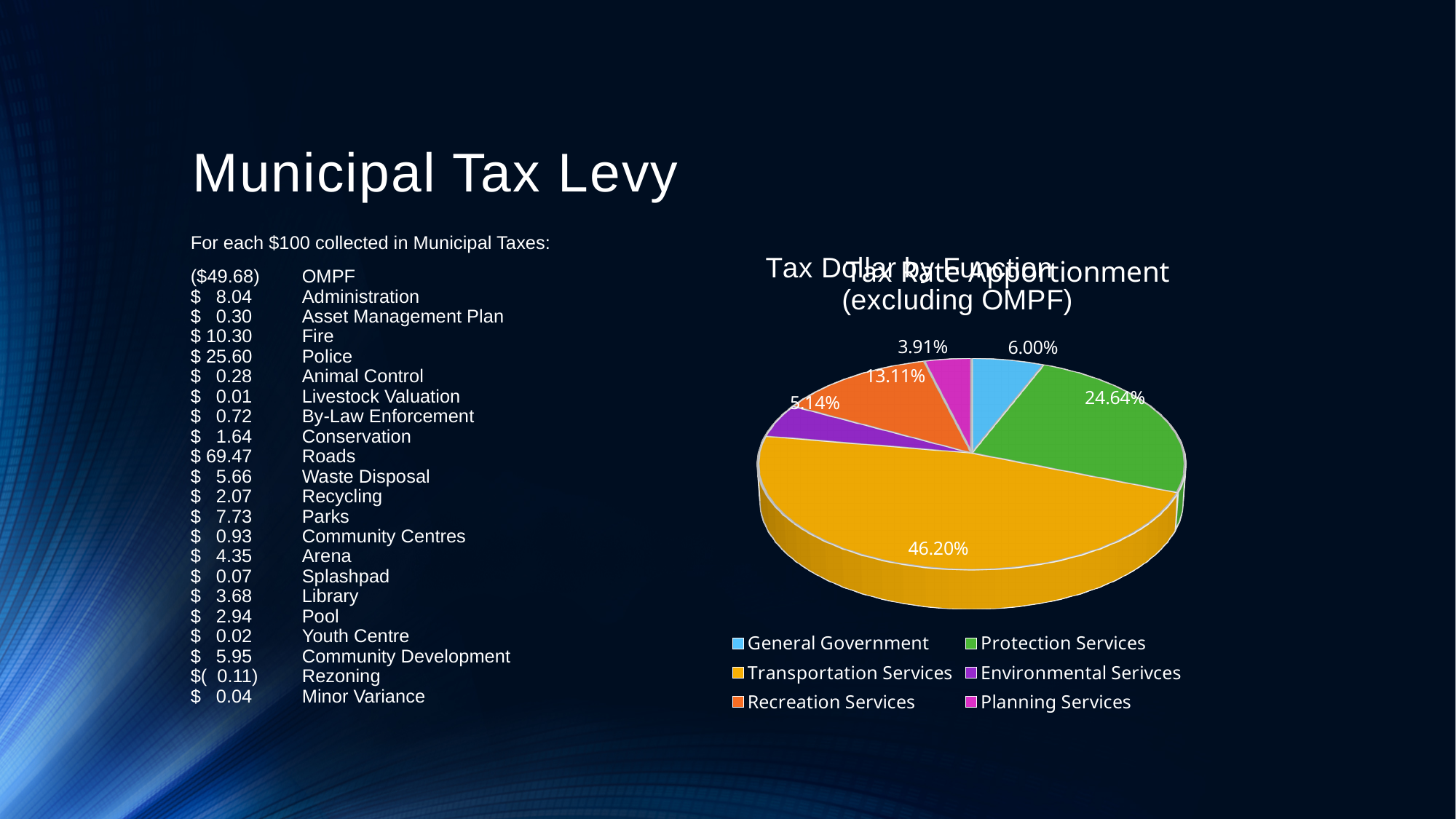
Which category has the smallest slice of the pie? Planning Services What percentage of the pie is Transportation Services? 46.20% What percentage of the pie is Protection Services? 24.64% Which slice is larger, Recreation Services or General Government? Recreation Services What is the difference in percentage points between Transportation Services and Protection Services? 21.56 How many categories does the legend of the pie chart list? 6 What percentage of the pie is Recreation Services? 13.11% What percentage of the pie is General Government? 6.00% What kind of chart is shown on the slide? pie chart Which category has the largest slice of the pie? Transportation Services What percentage of the pie is Planning Services? 3.91% What percentage of the pie is Environmental Services? 5.14%